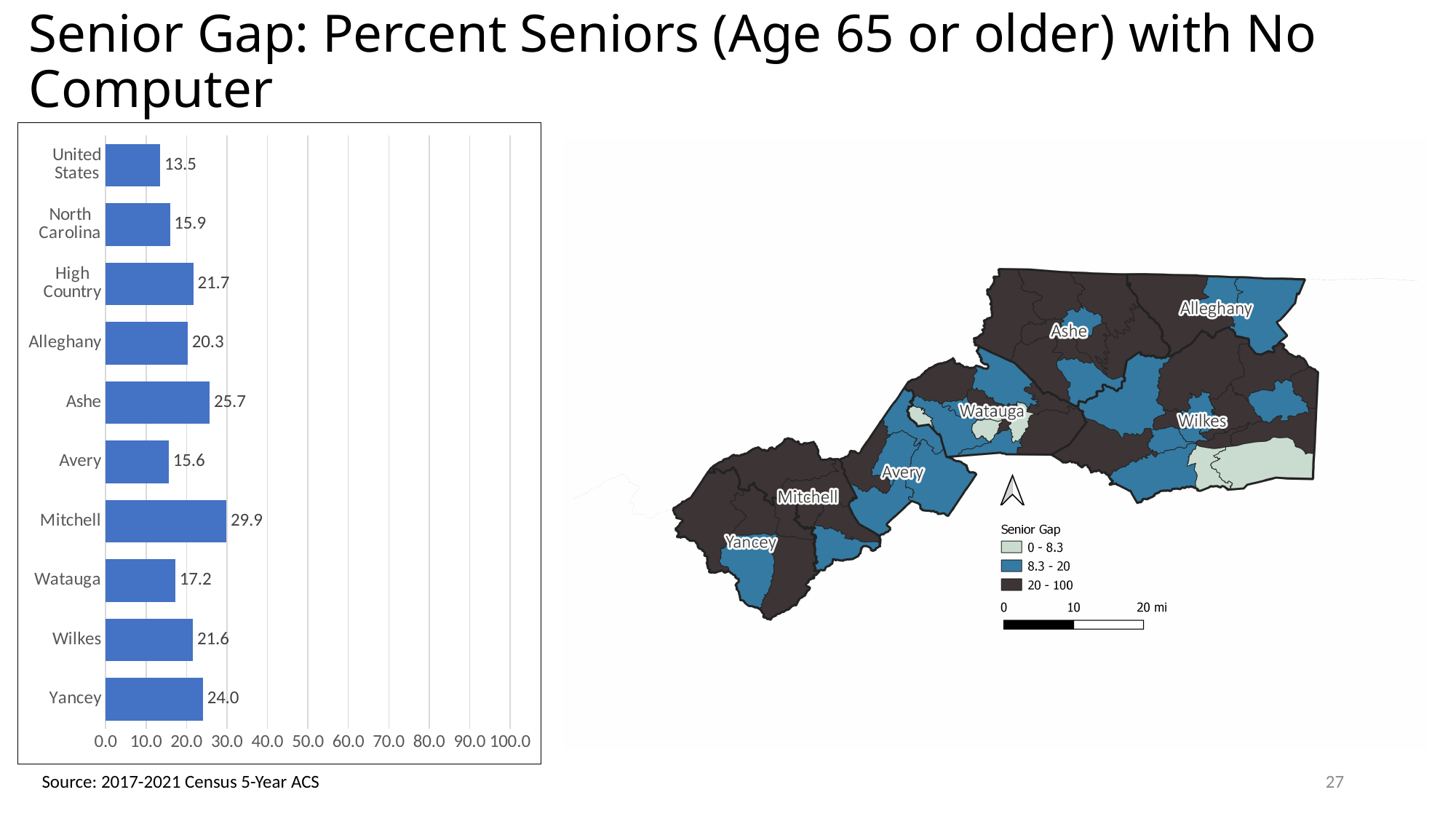
In the bar chart, which category has the highest value? Mitchell In the bar chart, which category has the lowest value? United States How many categories are shown in the bar chart? 10 In the bar chart, what is the value for North Carolina? 15.9 In the bar chart, what is the difference between the values for Mitchell and United States? 16.4 What kind of chart is shown on the left of the slide? bar chart In the bar chart, which is larger, the value for Yancey or the value for Wilkes? Yancey In the bar chart, what is the value for Watauga? 17.2 In the bar chart, what is the difference between the values for Ashe and Avery? 10.1 In the bar chart, is the value for Ashe greater or less than 20.0? greater In the bar chart, what is the value for Mitchell? 29.9 How many classes does the Senior Gap legend on the map list? 3